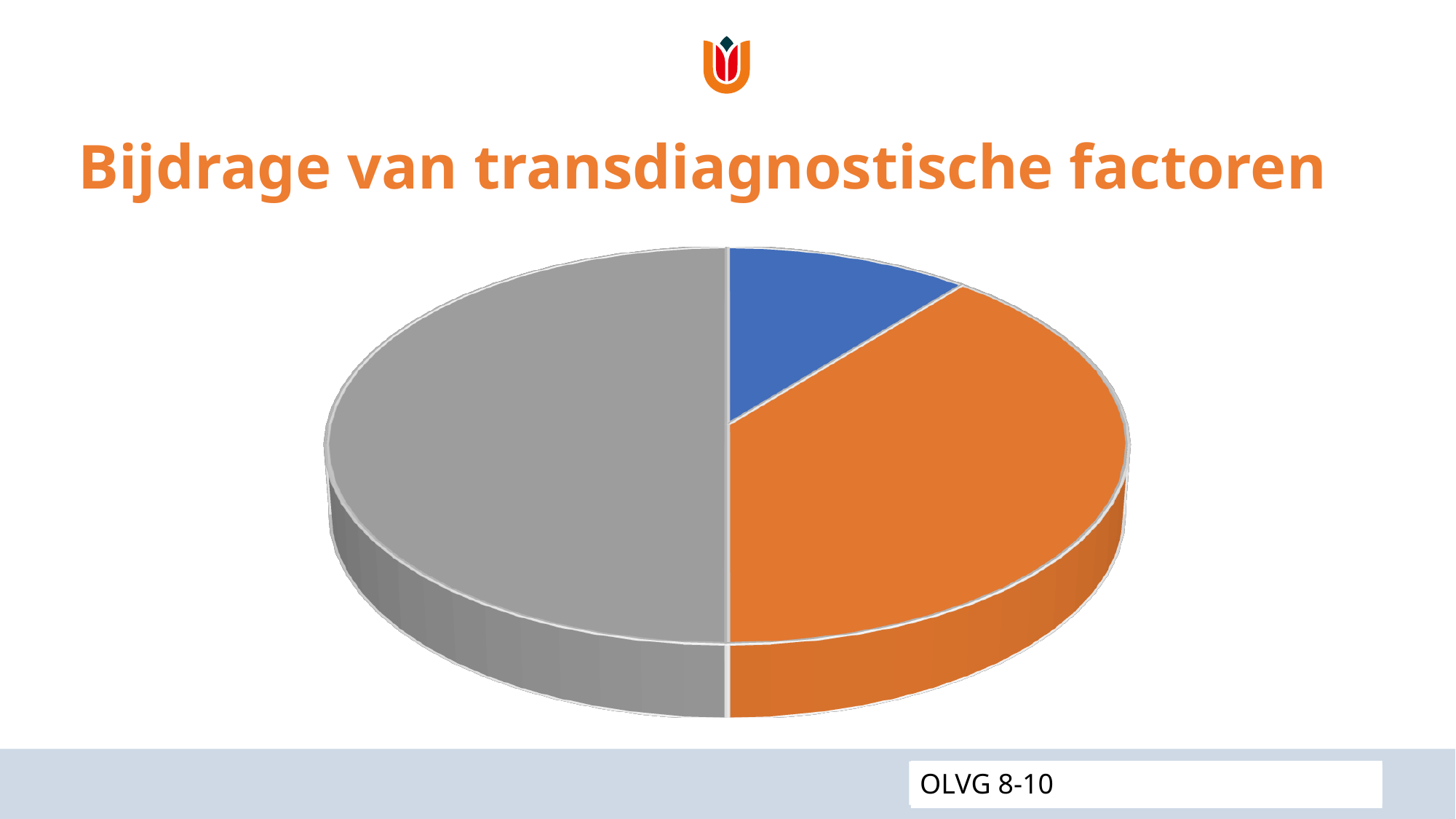
Does the pie chart display a legend? No Which slice is larger, the gray slice or the orange slice? gray Is the gray slice's share of the pie greater or less than 25%? greater What is the title of the slide containing the pie chart? Bijdrage van transdiagnostische factoren How many slices does the pie chart have? 3 What kind of chart is shown on the slide? pie chart Which colour slice is the largest in the pie chart? gray Which colour slice is the smallest in the pie chart? blue Which slice is larger, the orange slice or the blue slice? orange Is the blue slice's share of the pie greater or less than 25%? less